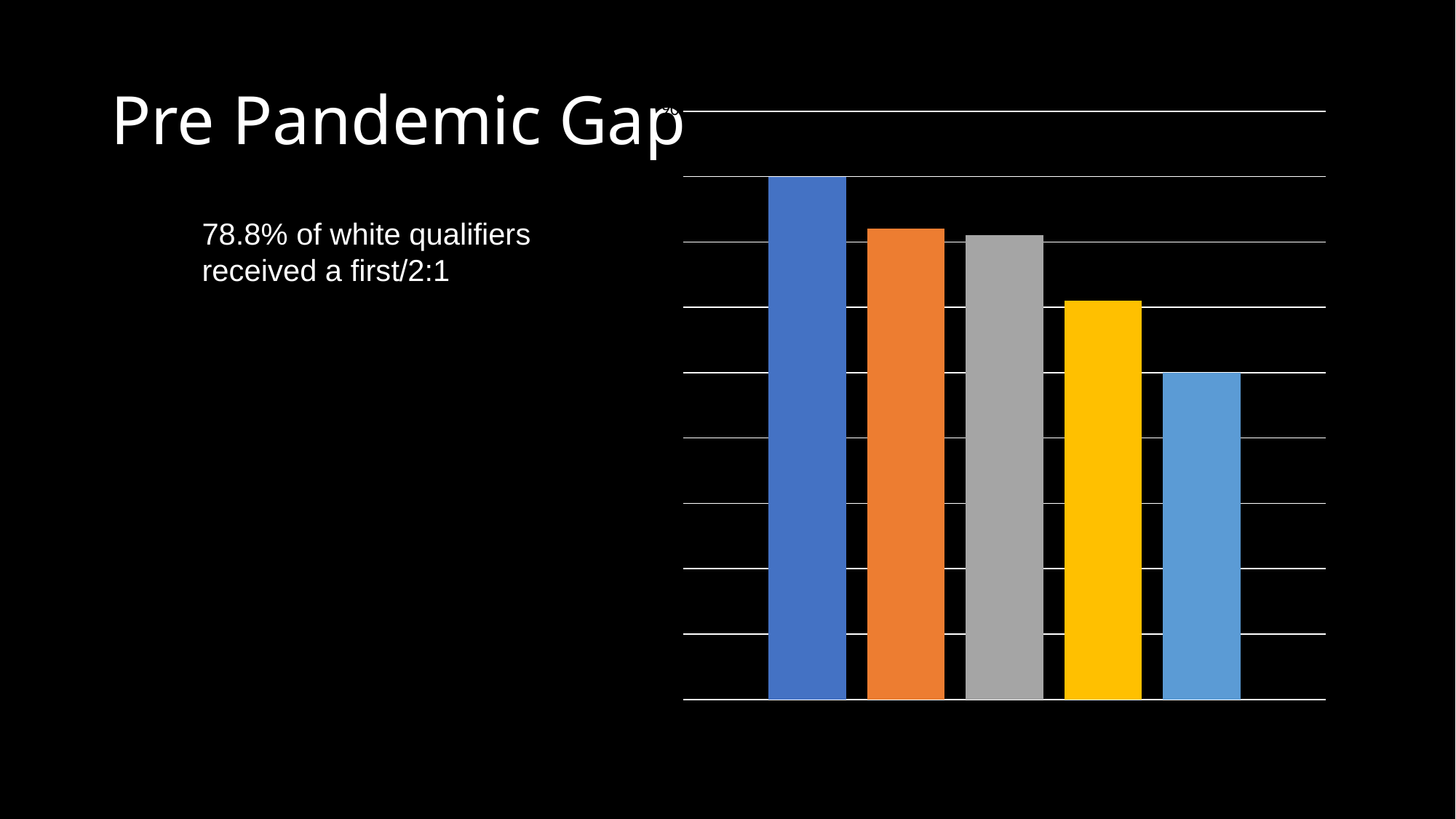
Which bar in the chart is the shortest? the last (light blue) bar on the right Which bar in the chart is the tallest? the first (dark blue) bar on the left What is the title shown on the slide above the chart? Pre Pandemic Gap Which is taller, the grey bar or the light blue bar on the right? the grey bar Which is taller, the orange bar or the yellow bar? the orange bar Which is taller, the dark blue bar on the left or the orange bar? the dark blue bar What kind of chart is shown on the slide? bar chart What colour is the tallest bar in the chart? dark blue Do the bar values rise or fall from left to right across the chart? fall How many bars does the chart show? 5